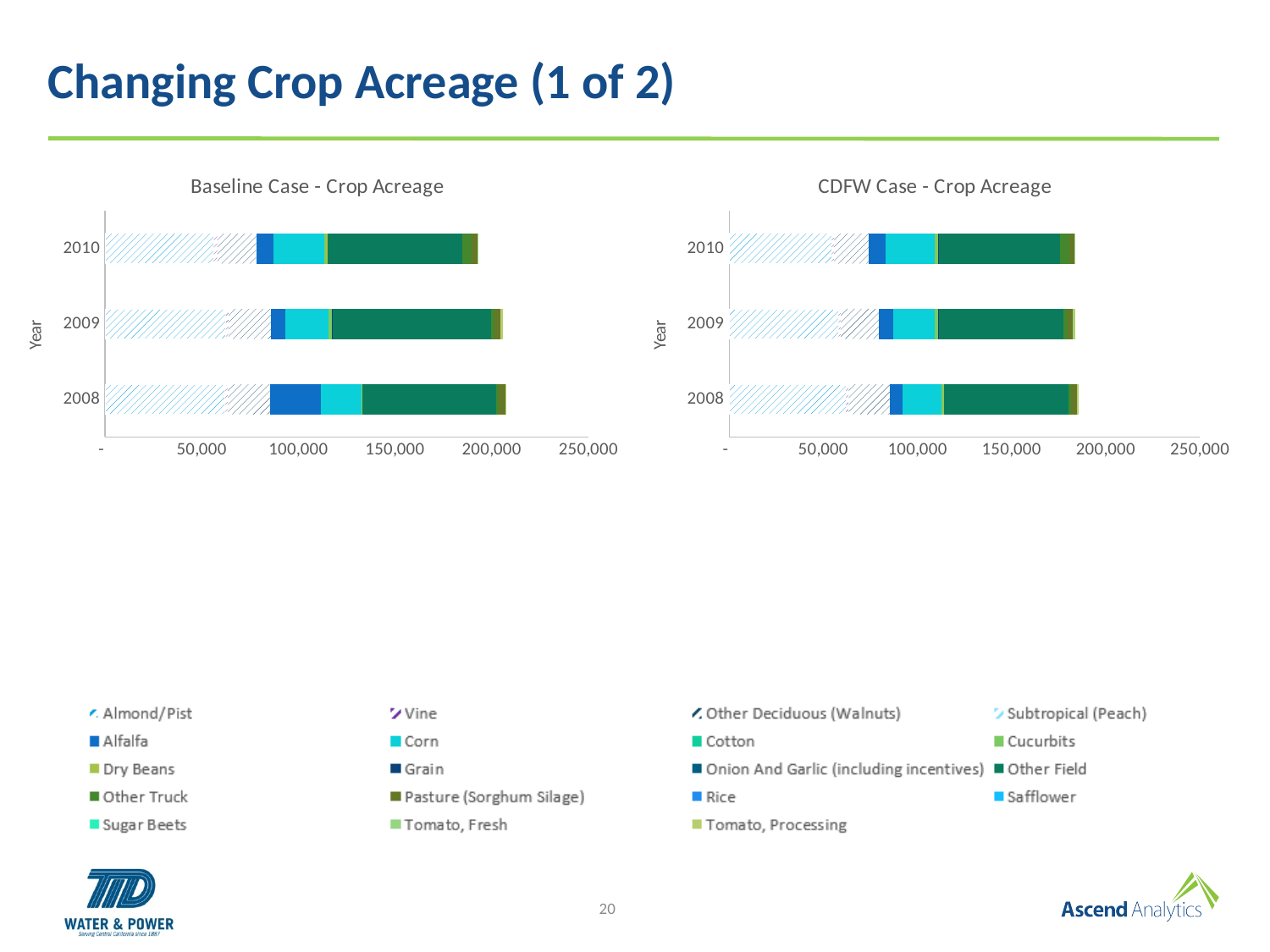
In the Baseline Case - Crop Acreage chart, is the total acreage for 2008 greater or less than 200,000? greater What is the label on the vertical axis of the Baseline Case - Crop Acreage chart? Year What kind of chart is the Baseline Case - Crop Acreage chart? Stacked bar chart How many crop categories does the legend list? 19 For 2010, which chart shows the larger total acreage, Baseline Case or CDFW Case? Baseline Case In the CDFW Case - Crop Acreage chart, is the total acreage for 2008 greater or less than 150,000? greater In the Baseline Case - Crop Acreage chart, which year has the larger total acreage, 2008 or 2010? 2008 In the Baseline Case - Crop Acreage chart, which year has the smallest total acreage? 2010 In the CDFW Case - Crop Acreage chart, is the total acreage for 2010 greater or less than 200,000? less How many years are shown on the CDFW Case - Crop Acreage chart? 3 What is the highest value shown on the x axis of the CDFW Case - Crop Acreage chart? 250,000